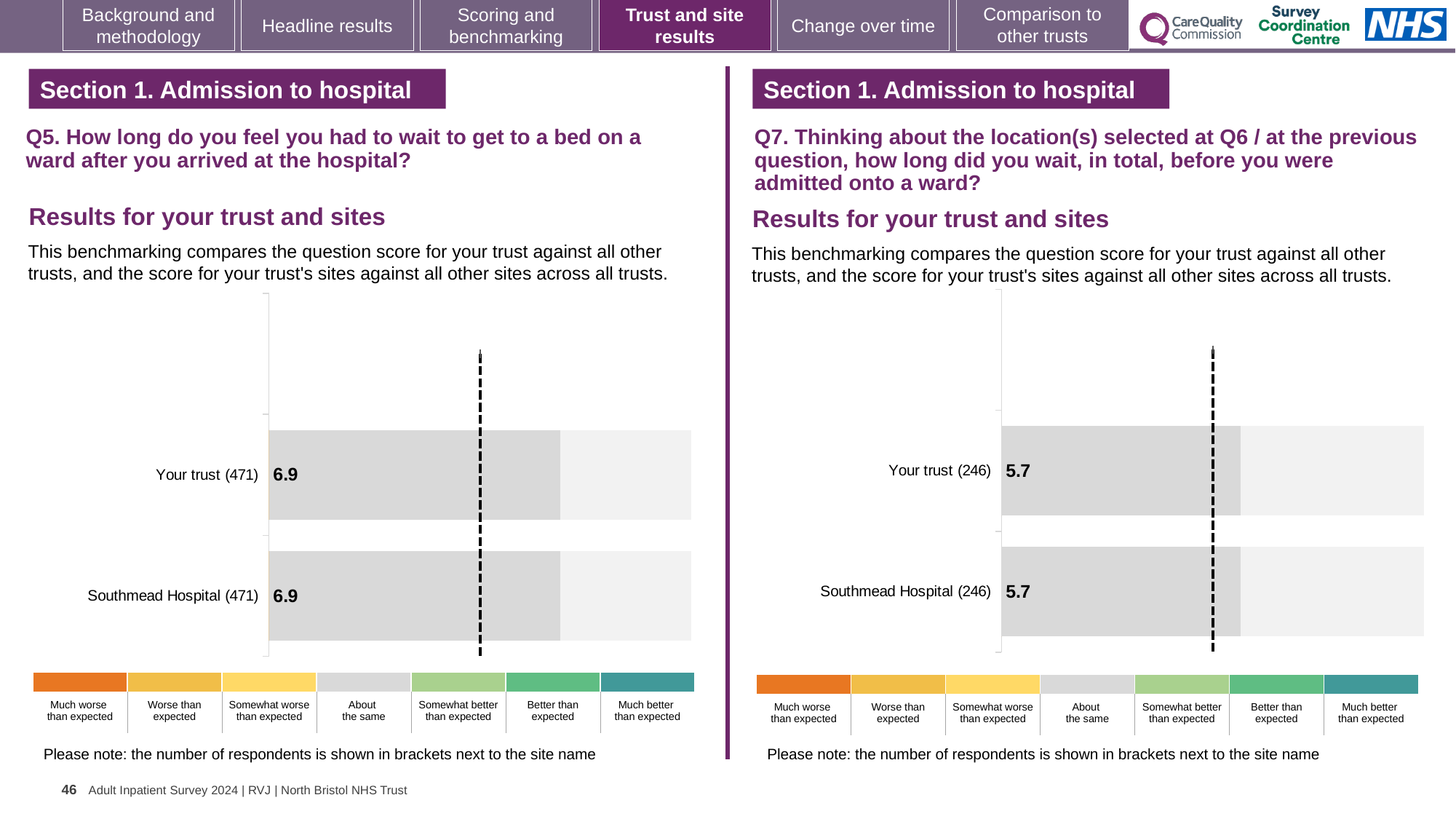
On the Q5 chart (left), how many respondents are shown in brackets for Your trust? 471 On the Q7 chart (right), what is the score for Southmead Hospital? 5.7 On the Q7 chart (right), how many respondents are shown in brackets for Southmead Hospital? 246 How many bars are plotted on the Q5 chart (left)? 2 How many bars are plotted on the Q7 chart (right)? 2 On the Q5 chart (left), what is the score for Southmead Hospital? 6.9 On the Q5 chart (left), what is the difference between the score for Your trust and the score for Southmead Hospital? 0 On the Q5 chart (left), what is the score for Your trust? 6.9 Is the score for Your trust on the Q5 chart (left) larger or smaller than the score for Your trust on the Q7 chart (right)? Larger What kind of chart is the Q5 chart (left)? Bar chart On the Q7 chart (right), what is the difference between the score for Your trust and the score for Southmead Hospital? 0 On the Q7 chart (right), what is the score for Your trust? 5.7